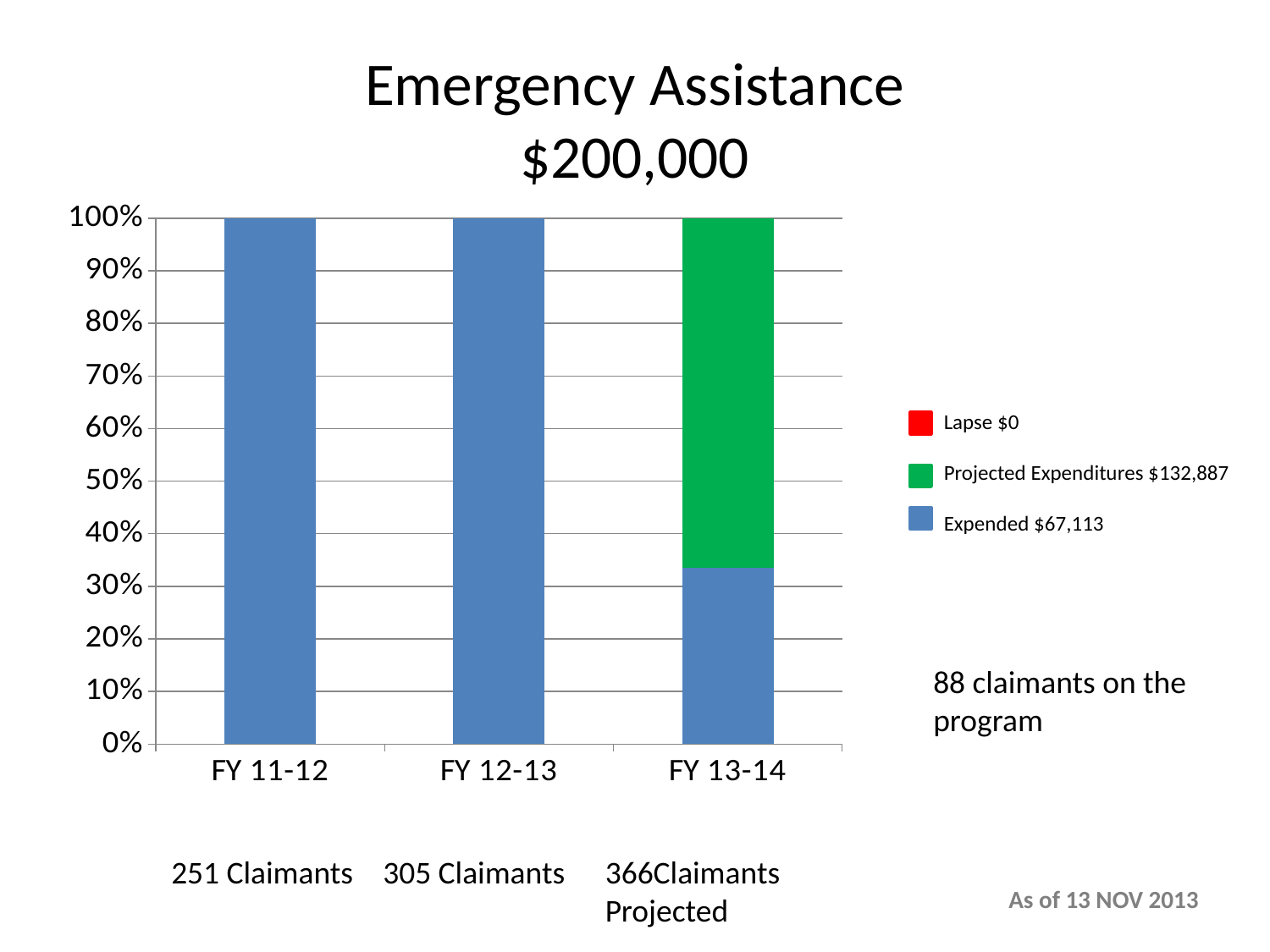
Is the Projected Expenditures share for FY 13-14 greater or less than 50%? greater Is the Expended share for FY 13-14 greater or less than 50%? less What dollar amount does the legend give for Projected Expenditures? $132,887 Which fiscal year has the lowest Expended share? FY 13-14 Which has the larger Expended share, FY 11-12 or FY 13-14? FY 11-12 What is the Expended share for FY 12-13? 100% Is the Expended share for FY 13-14 greater or less than 30%? greater What is the Expended share for FY 11-12? 100% What kind of chart is shown on the slide? bar chart How many fiscal years are shown on the x axis of the chart? 3 How many series does the chart's legend list? 3 What dollar amount does the legend give for Expended? $67,113